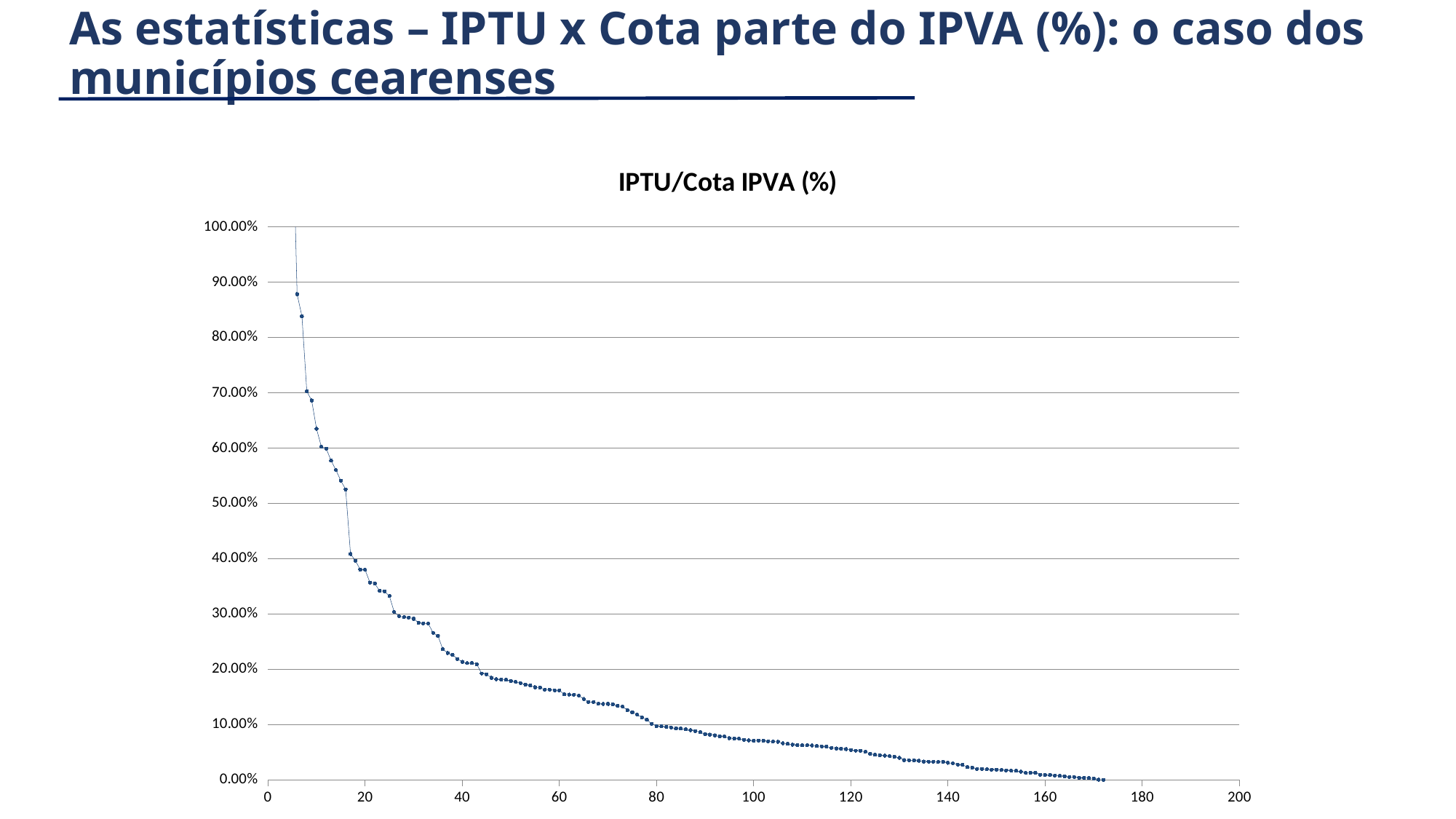
Do the values rise or fall as you move along the x axis from left to right? fall What is the largest value labelled on the x axis? 200 What is the highest value shown on the y axis? 100.00% Is the value at x = 100 greater or less than 10%? less What is the title of the chart? IPTU/Cota IPVA (%) Is the value at x = 60 greater or less than 20%? less Is the value at x = 10 greater or less than 50%? greater Which is larger, the value at x = 20 or the value at x = 80? the value at x = 20 What kind of chart is shown on the slide? line chart